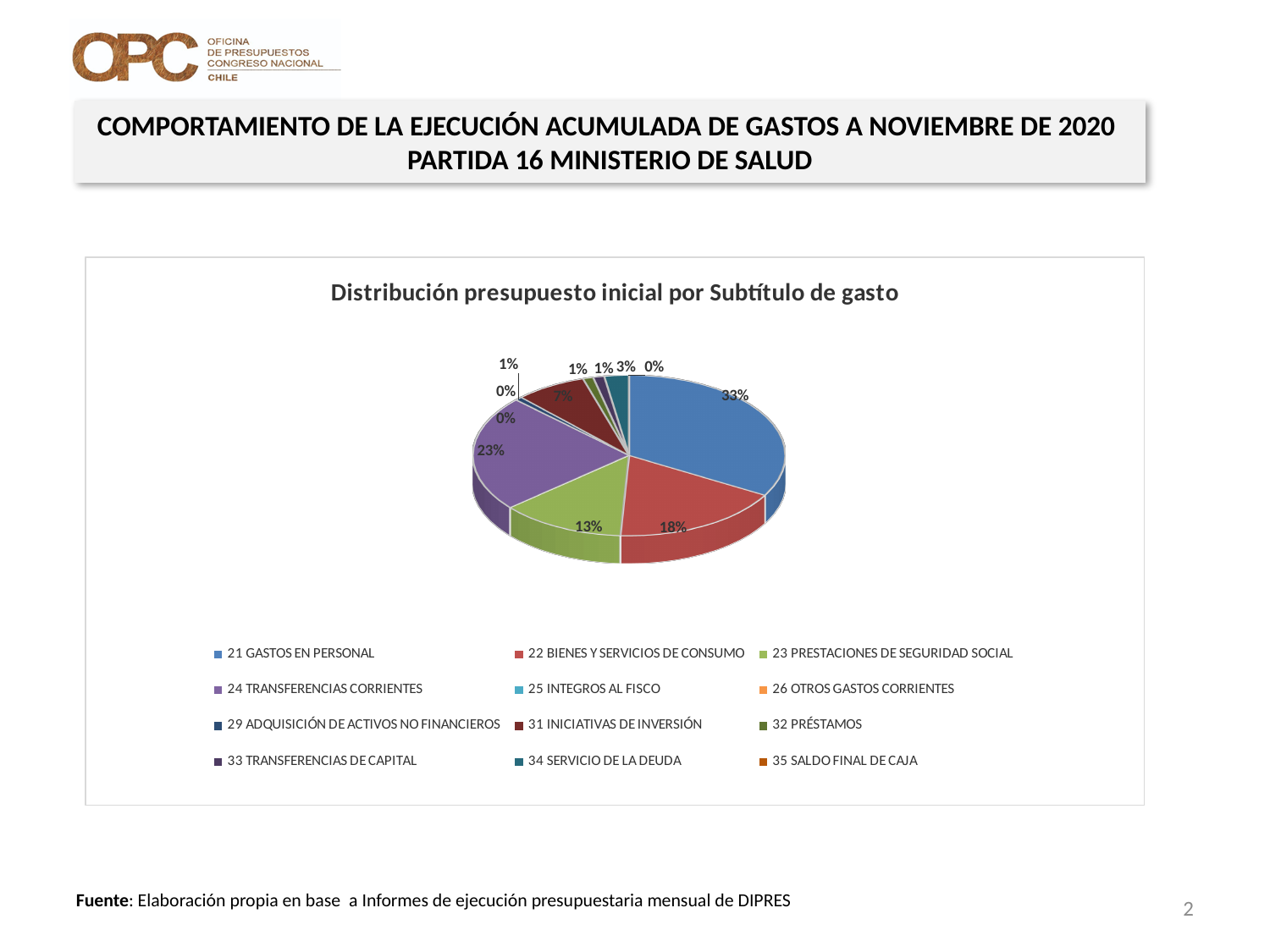
Which category has the largest share of the pie? 21 GASTOS EN PERSONAL What share of the pie does 23 PRESTACIONES DE SEGURIDAD SOCIAL represent? 13% What is the title of the chart? Distribución presupuesto inicial por Subtítulo de gasto Which is larger, the share for 24 TRANSFERENCIAS CORRIENTES or for 22 BIENES Y SERVICIOS DE CONSUMO? 24 TRANSFERENCIAS CORRIENTES What is the difference in percentage points between the share for 21 GASTOS EN PERSONAL and the share for 22 BIENES Y SERVICIOS DE CONSUMO? 15 percentage points What share of the pie does 24 TRANSFERENCIAS CORRIENTES represent? 23% What share of the pie does 21 GASTOS EN PERSONAL represent? 33% How many categories does the chart's legend list? 12 What kind of chart is shown on the slide? Pie chart